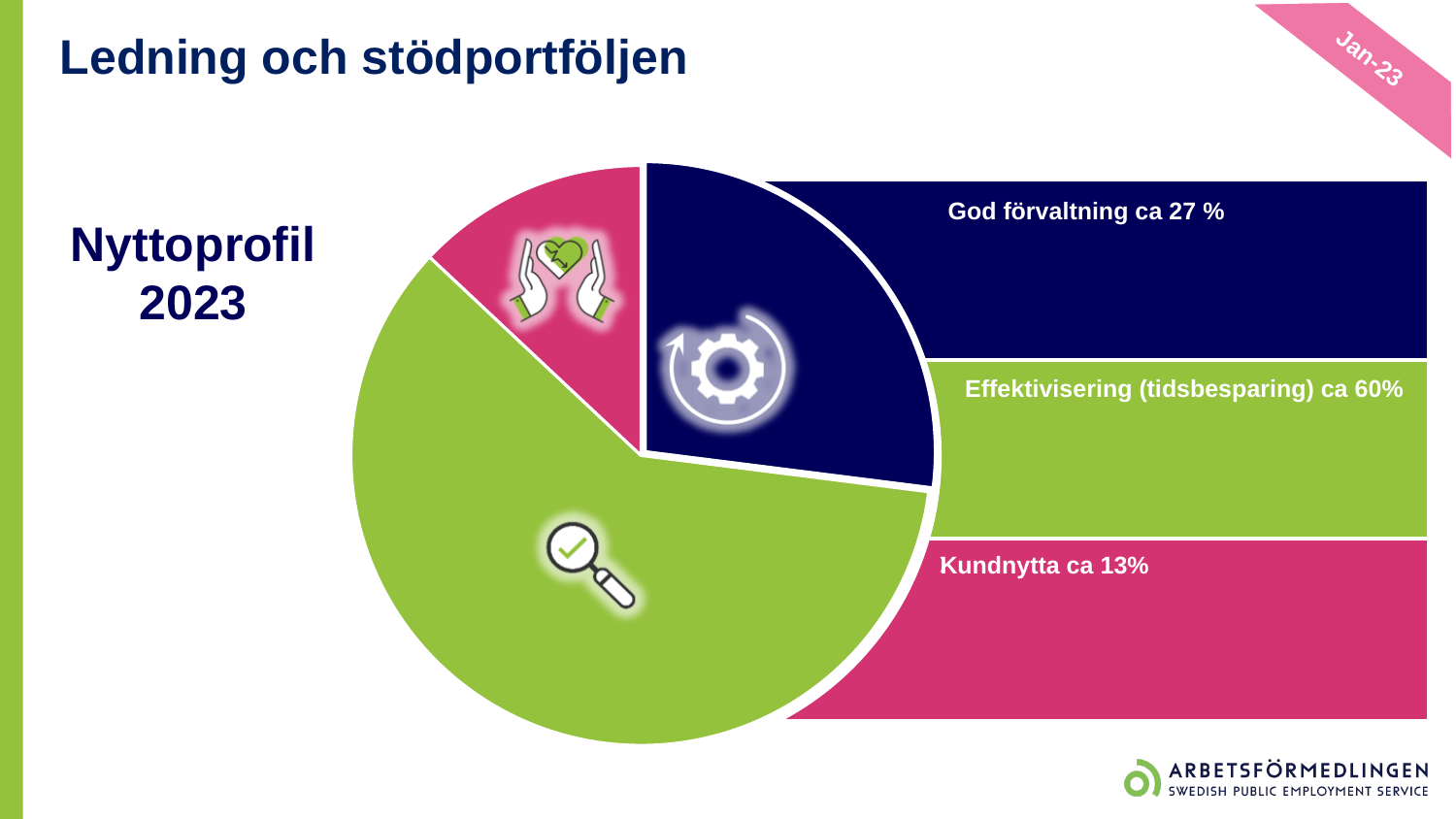
How many slices does the pie chart have? 3 What is the title shown to the left of the pie chart? Nyttoprofil 2023 Which category has the largest slice of the pie? Effektivisering (tidsbesparing) By how many percentage points does God förvaltning exceed Kundnytta? 14 percentage points By how many percentage points does Effektivisering (tidsbesparing) exceed God förvaltning? 33 percentage points Which category has the smallest slice of the pie? Kundnytta What kind of chart is shown on the slide? pie chart Which is larger, the slice for God förvaltning or the slice for Kundnytta? God förvaltning What share of the pie is labelled for Effektivisering (tidsbesparing)? ca 60% What colour is the slice for Kundnytta? pink What share of the pie is labelled for God förvaltning? ca 27 % What share of the pie is labelled for Kundnytta? ca 13%